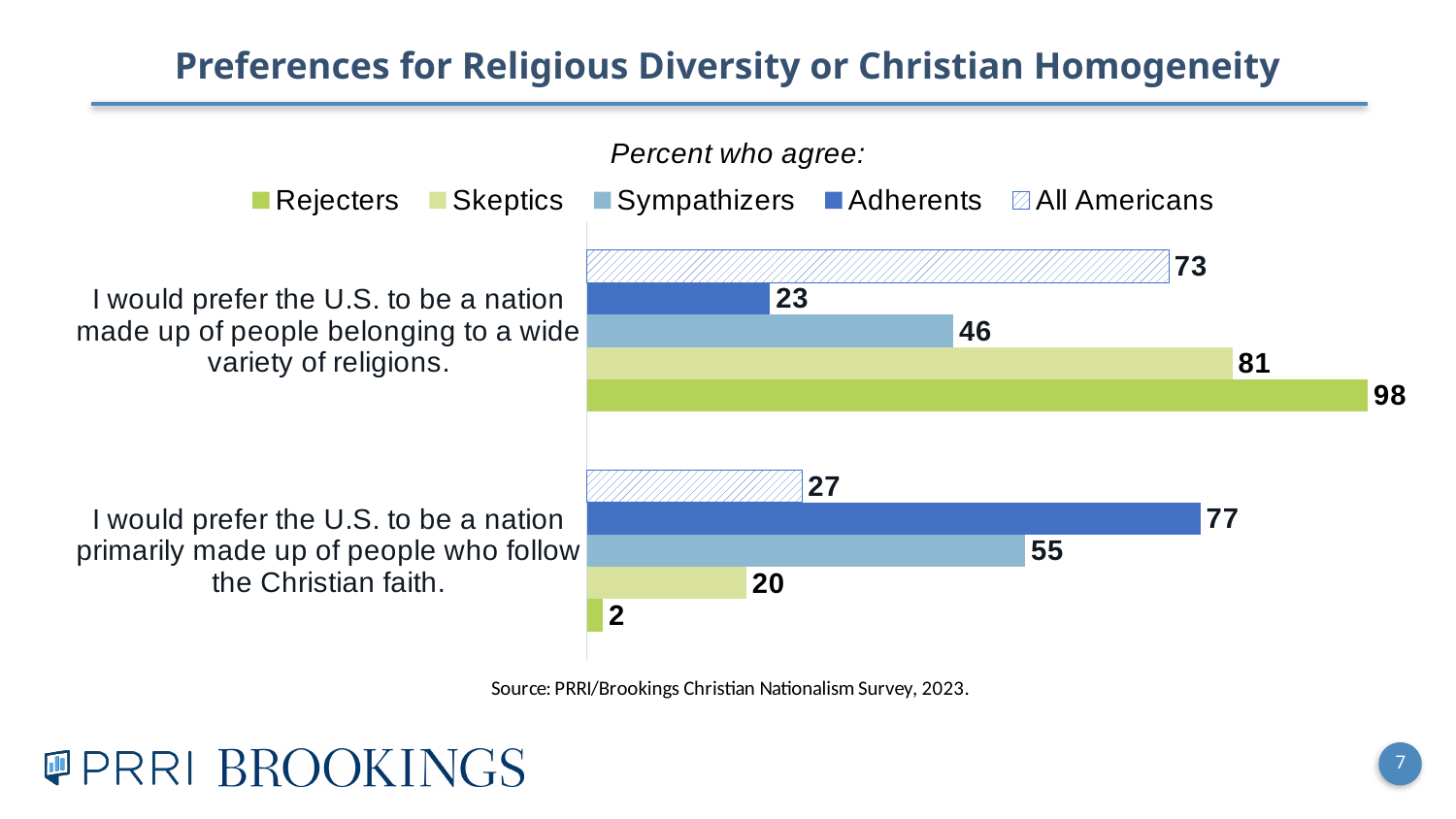
How many series does the legend list? 5 What is the difference between the Skeptics and Adherents values for preferring a nation made up of people belonging to a wide variety of religions? 58 What kind of chart is shown on the slide? Bar chart What is the title of the slide's chart? Percent who agree: What percent of Sympathizers agree that they would prefer the U.S. to be a nation primarily made up of people who follow the Christian faith? 55 Which is larger: the Sympathizers value for preferring a wide variety of religions, or the Sympathizers value for preferring a nation primarily of people who follow the Christian faith? Preferring a nation primarily of people who follow the Christian faith (55) Which group has the lowest value for preferring a nation primarily made up of people who follow the Christian faith? Rejecters Which group has the highest value for preferring a nation made up of people belonging to a wide variety of religions? Rejecters What percent of All Americans agree that they would prefer the U.S. to be a nation made up of people belonging to a wide variety of religions? 73 What is the difference between the Adherents and Rejecters values for preferring a nation primarily made up of people who follow the Christian faith? 75 What percent of Adherents agree that they would prefer the U.S. to be a nation primarily made up of people who follow the Christian faith? 77 What percent of Rejecters agree that they would prefer the U.S. to be a nation made up of people belonging to a wide variety of religions? 98